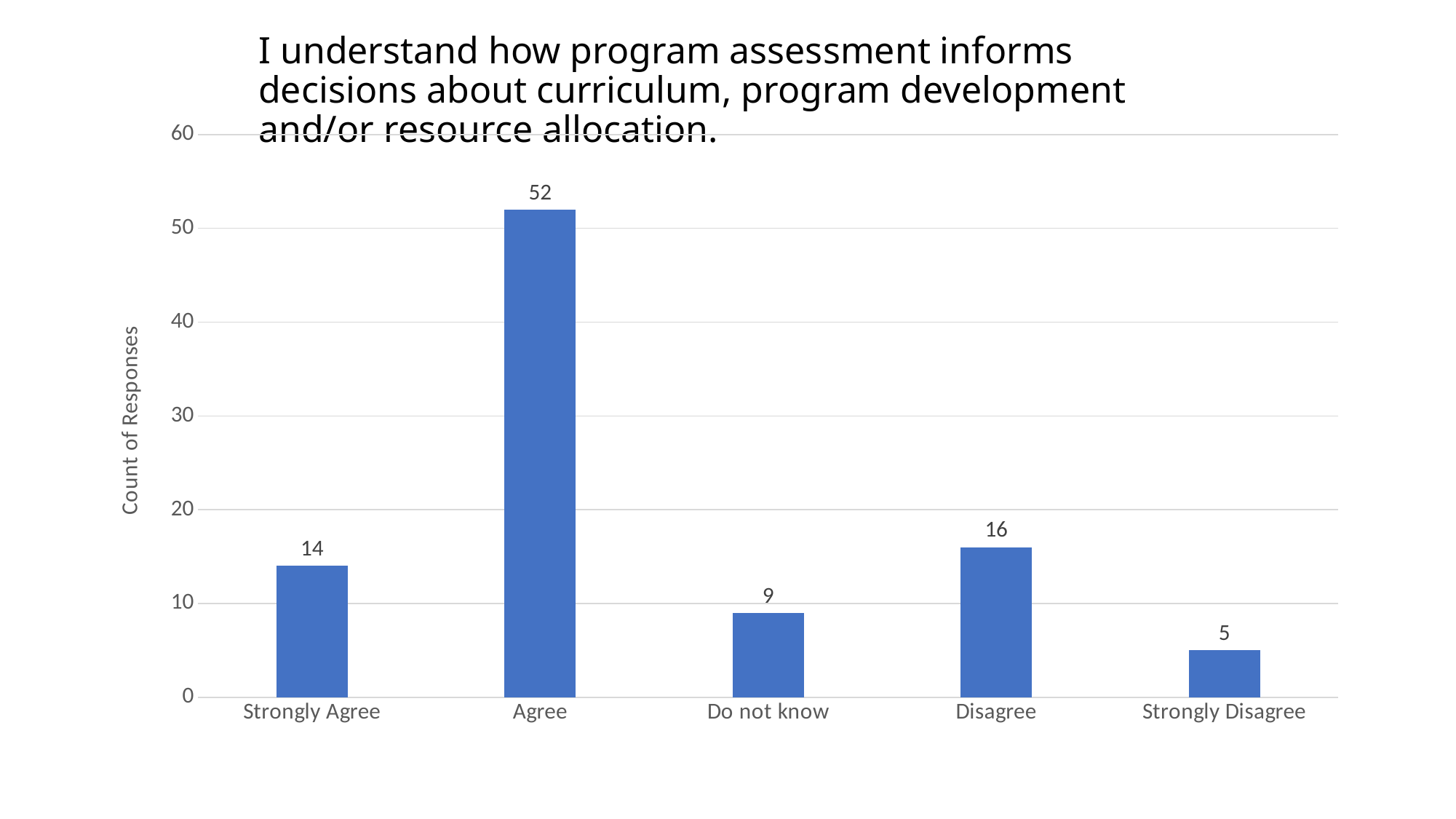
How many categories are shown on the x axis? 5 What is the difference between the counts for Strongly Agree and Do not know? 5 Is the value for Agree greater or less than 50? greater Which has more responses, Disagree or Strongly Agree? Disagree What type of chart is shown on the slide? Bar chart What is the count of responses for Agree? 52 What is the difference between the counts for Agree and Disagree? 36 What is the count of responses for Strongly Agree? 14 Which category has the lowest count of responses? Strongly Disagree What is the count of responses for Do not know? 9 What is the count of responses for Strongly Disagree? 5 Which category has the highest count of responses? Agree